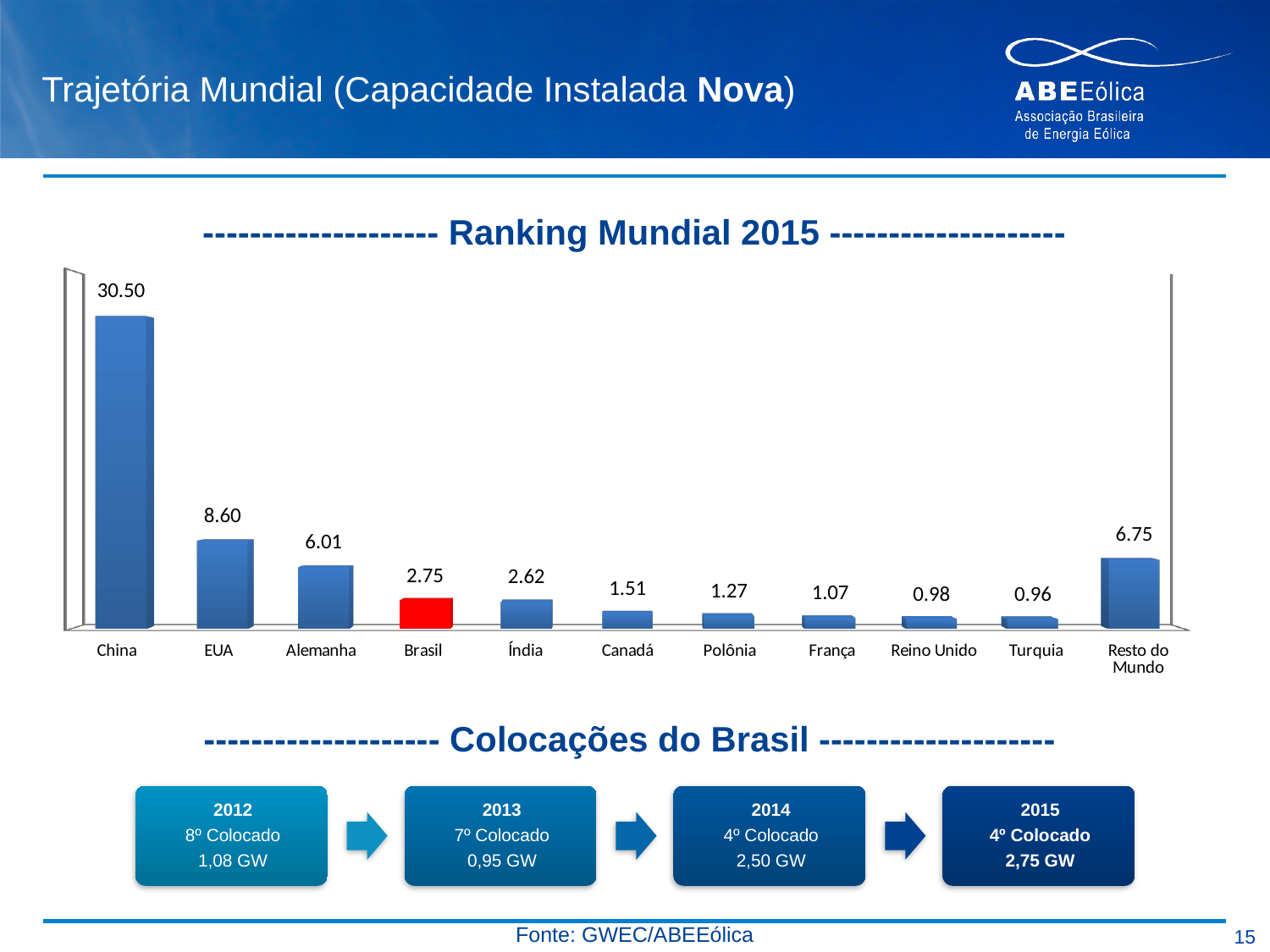
How many categories are shown in the Ranking Mundial 2015 chart? 11 Which category has the lowest value in the Ranking Mundial 2015 chart? Turquia What is the difference between the values for EUA and Alemanha in the Ranking Mundial 2015 chart? 2.59 What kind of chart is the Ranking Mundial 2015 chart? Bar chart What is the difference between the values for China and EUA in the Ranking Mundial 2015 chart? 21.90 Which category has the highest value in the Ranking Mundial 2015 chart? China Which bar in the Ranking Mundial 2015 chart is coloured red instead of blue? Brasil In the Ranking Mundial 2015 chart, which has a larger value, Índia or Canadá? Índia In the Ranking Mundial 2015 chart, which has a larger value, Resto do Mundo or Alemanha? Resto do Mundo What is the value shown for China in the Ranking Mundial 2015 chart? 30.50 What is the value shown for Brasil in the Ranking Mundial 2015 chart? 2.75 What is the value shown for Resto do Mundo in the Ranking Mundial 2015 chart? 6.75